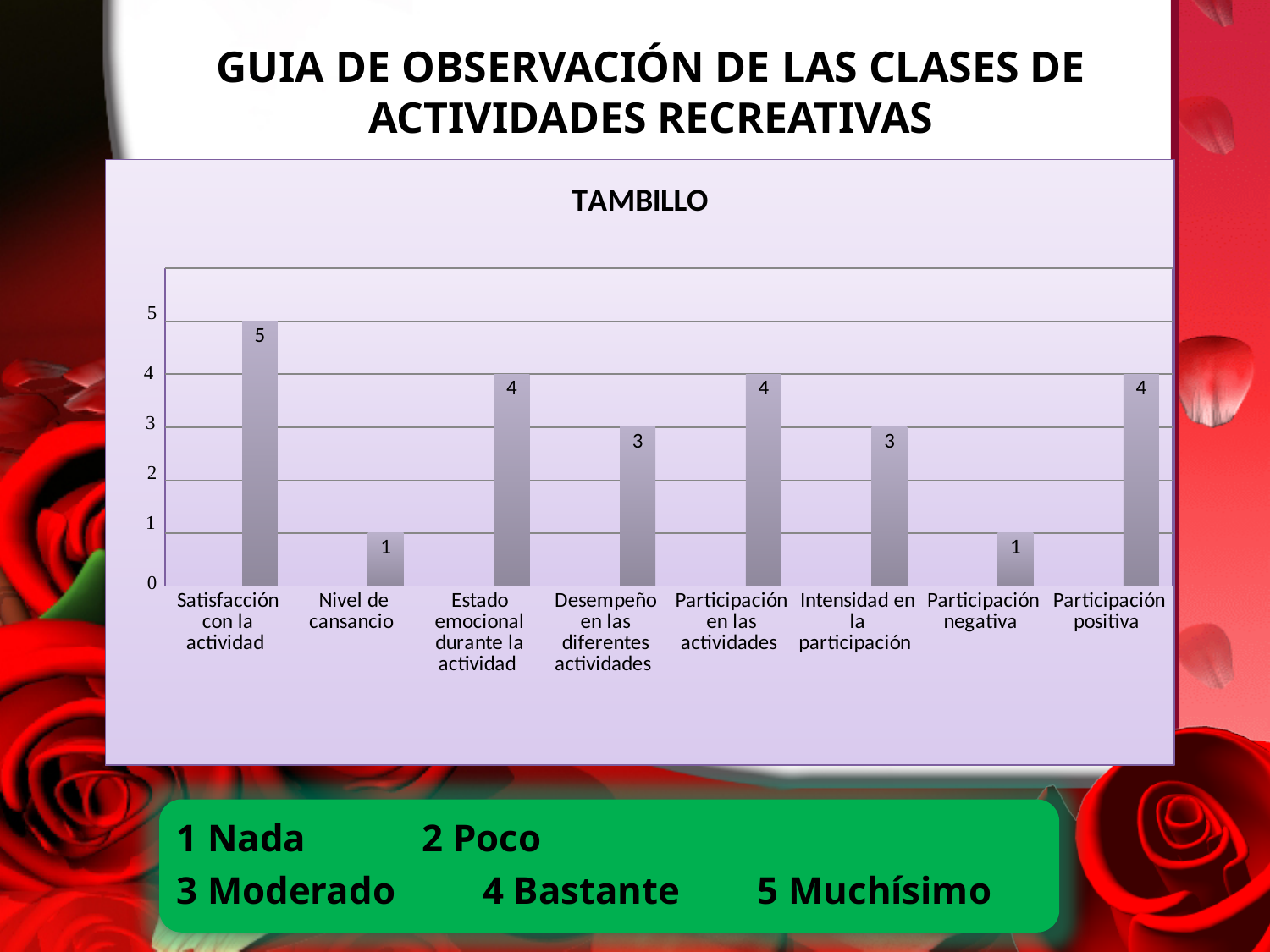
What is the value for "Desempeño en las diferentes actividades"? 3 What is the difference between the values for "Satisfacción con la actividad" and "Intensidad en la participación"? 2 Is the value for "Participación en las actividades" greater or less than 3? greater What is the value for "Satisfacción con la actividad"? 5 How many categories have a value of 4? 3 What is the value for "Participación negativa"? 1 What is the title of the chart? TAMBILLO What is the value for "Nivel de cansancio"? 1 Which category has the highest value? Satisfacción con la actividad Which is larger, the value for "Estado emocional durante la actividad" or the value for "Desempeño en las diferentes actividades"? Estado emocional durante la actividad How many categories are shown on the x axis? 8 What kind of chart is shown on the slide? Bar chart